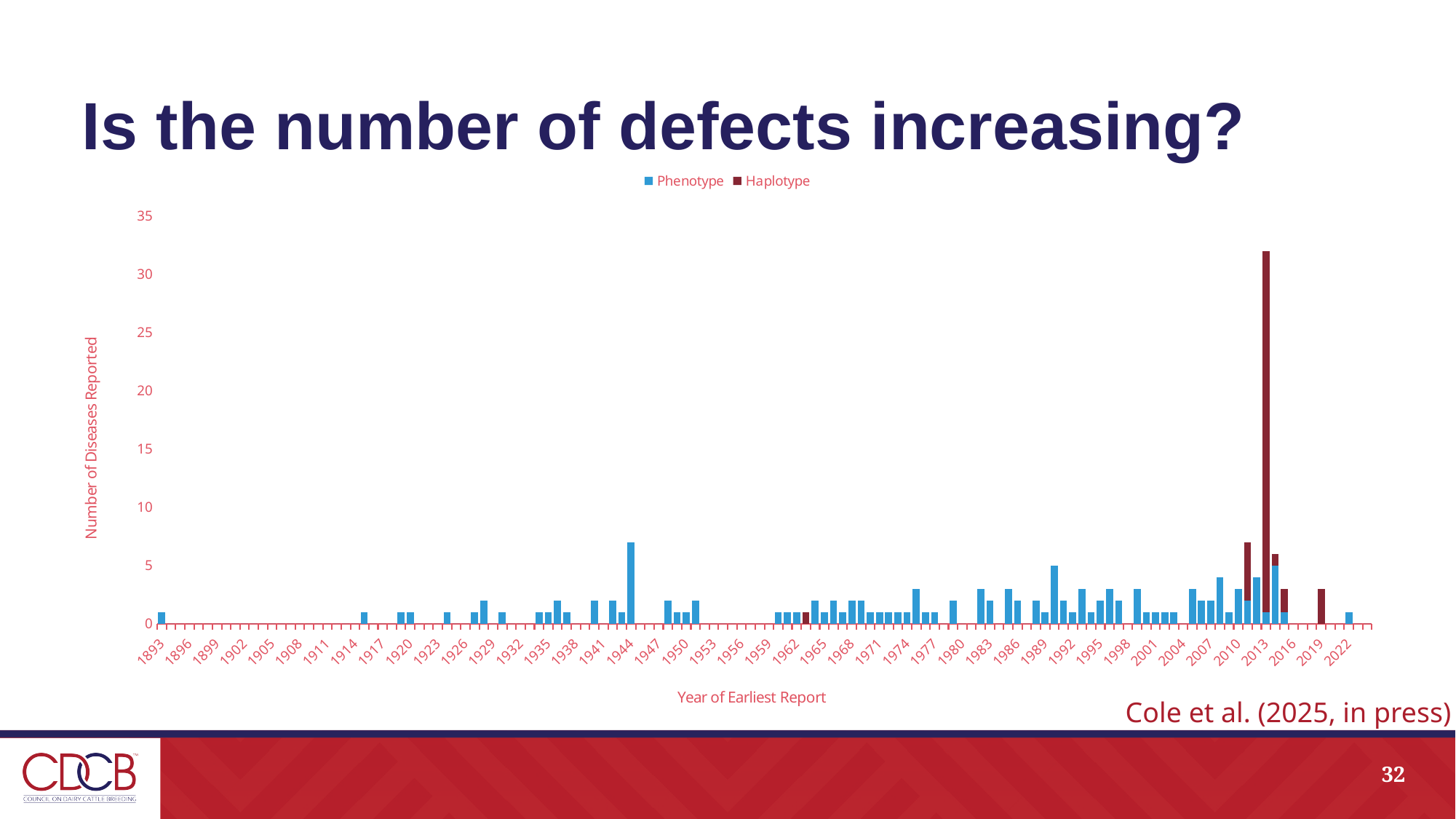
Is the tallest bar on the chart greater or less than 25? greater How many series does the legend list? 2 What is the first year shown on the x axis? 1893 What is the title of the y axis? Number of Diseases Reported What are the two series named in the legend? Phenotype and Haplotype Do the numbers of diseases reported generally rise or fall from the early years to the 2010s? Rise Is the value for 1893 greater or less than 5? less Which series does the tallest bar on the chart belong to? Haplotype Is the tallest Phenotype bar greater or less than 10? less Which is larger, the tallest bar around 2013 or the tallest bar in the 1940s? The bar around 2013 What kind of chart is shown on the slide? Bar chart